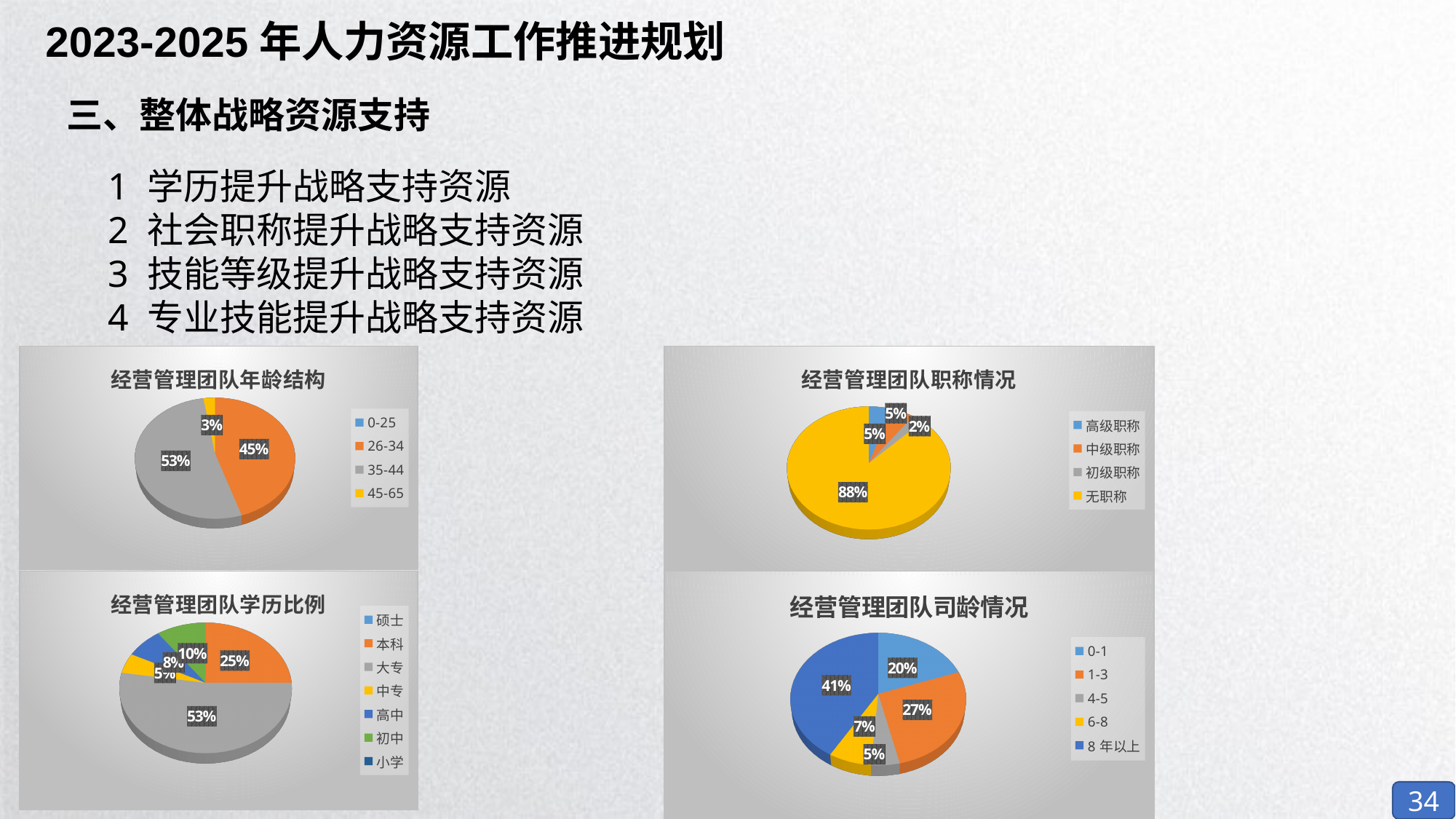
In the chart titled 经营管理团队司龄情况, which is larger, the share for 0-1 or the share for 1-3? 1-3 In the chart titled 经营管理团队年龄结构, what percentage is shown for the 35-44 group? 53% In the chart titled 经营管理团队职称情况, which category has the largest share? 无职称 In the chart titled 经营管理团队年龄结构, what percentage is shown for the 26-34 group? 45% In the chart titled 经营管理团队年龄结构, which age group has the largest share? 35-44 In the chart titled 经营管理团队司龄情况, what is the difference between the 8 年以上 share and the 1-3 share? 14% In the chart titled 经营管理团队司龄情况, what percentage is shown for 8 年以上? 41% What type of chart is the one titled 经营管理团队司龄情况? Pie chart In the chart titled 经营管理团队学历比例, what percentage is shown for 大专? 53% In the chart titled 经营管理团队学历比例, how many categories does the legend list? 7 In the chart titled 经营管理团队职称情况, what percentage is shown for 无职称? 88% In the chart titled 经营管理团队学历比例, what percentage is shown for 本科? 25%